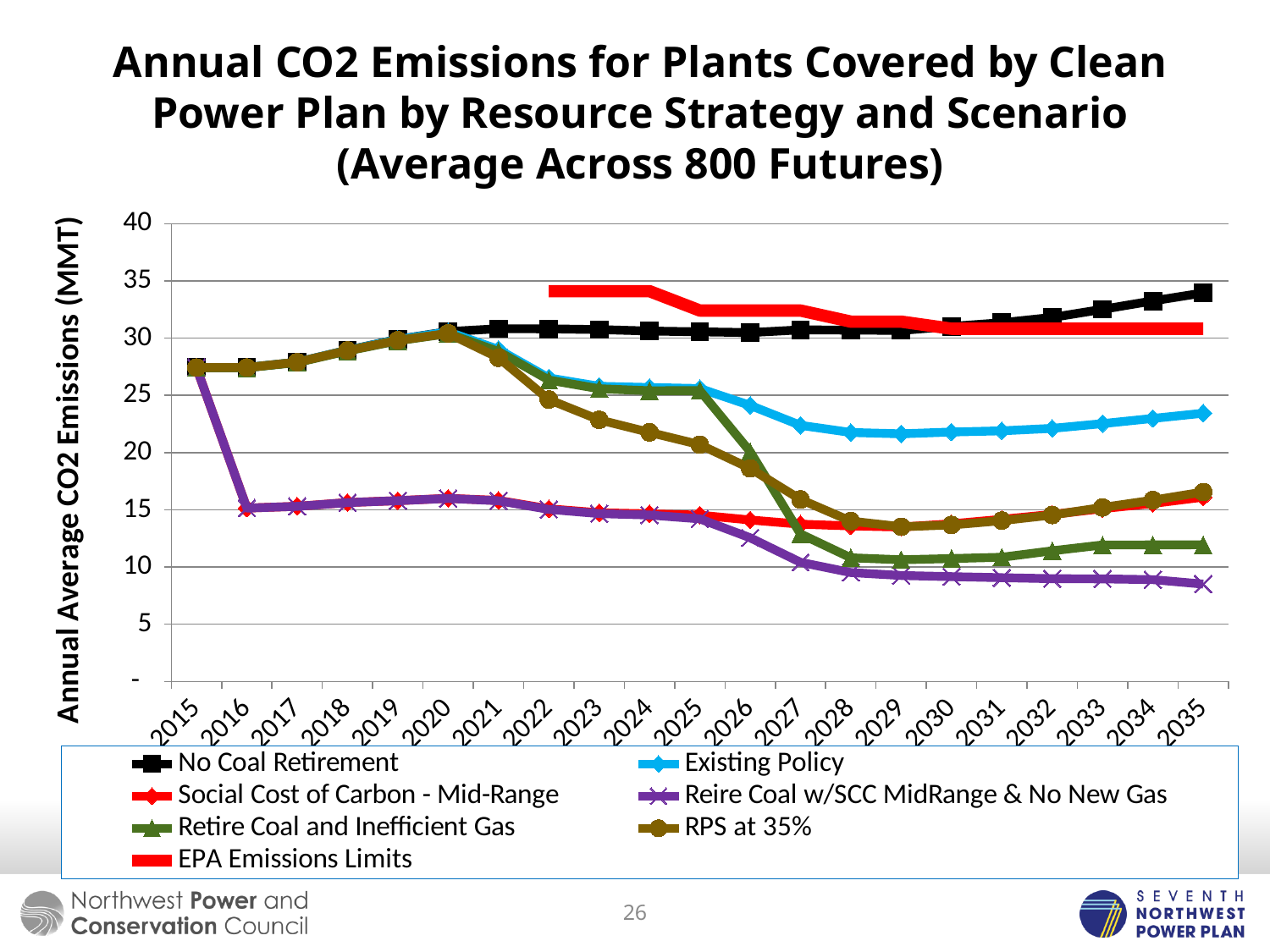
Which series has the highest value in 2035? No Coal Retirement Is the value for Reire Coal w/SCC MidRange & No New Gas in 2035 greater or less than 10? less Is the value for No Coal Retirement in 2035 greater or less than 30? greater What is the label on the y axis? Annual Average CO2 Emissions (MMT) How many series does the legend list? 7 Which series has the lowest value in 2035? Reire Coal w/SCC MidRange & No New Gas How many years are shown along the x axis? 21 Does the No Coal Retirement series rise or fall from 2030 to 2035? rise What kind of chart is shown on the slide? line chart Does the Existing Policy series rise or fall from 2020 to 2028? fall In 2035, which is larger: Existing Policy or RPS at 35%? Existing Policy Is the value for RPS at 35% in 2029 greater or less than 15? less